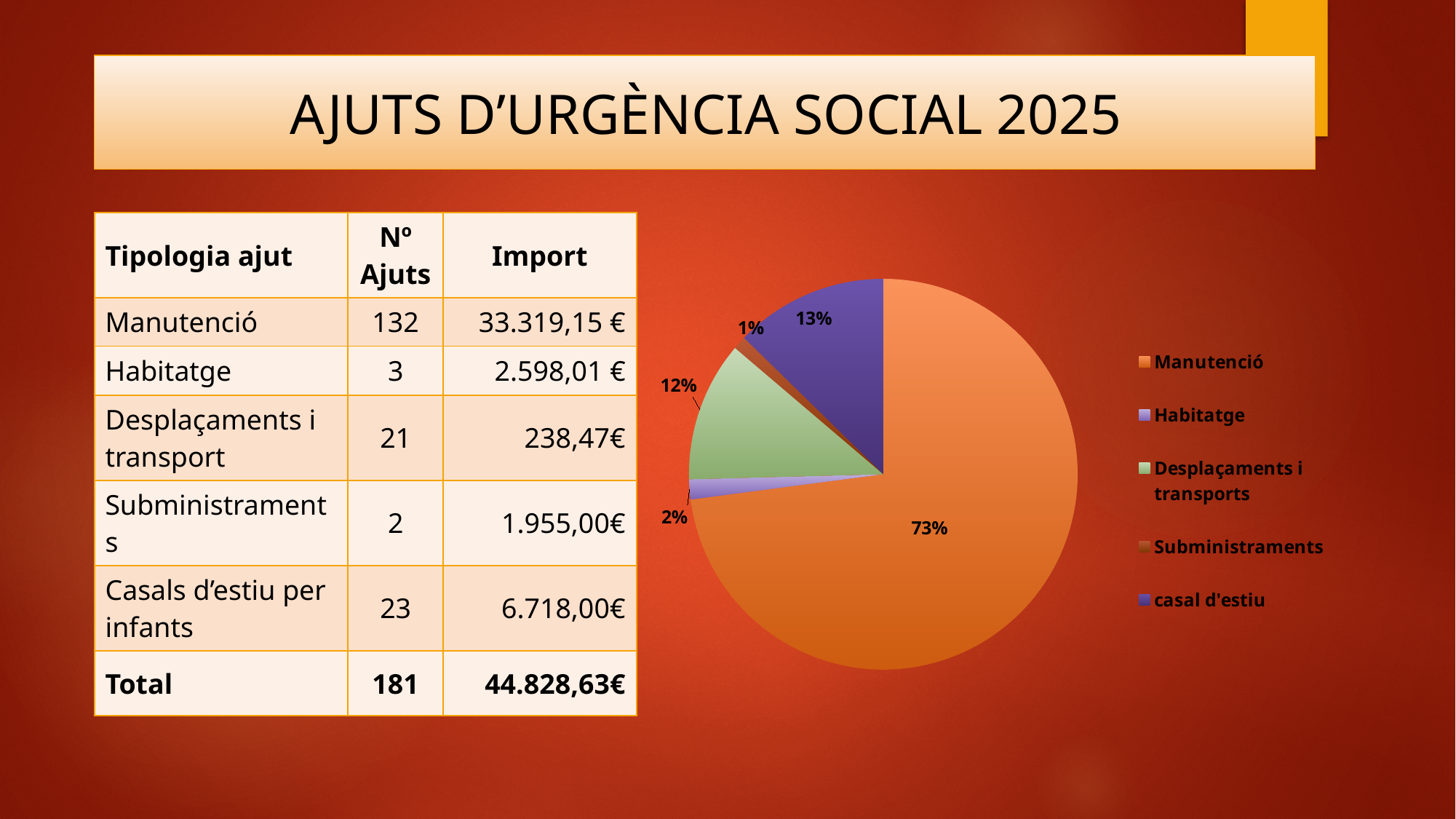
Which category has the largest slice in the pie chart? Manutenció What colour is the Manutenció slice in the pie chart? orange How many categories does the pie chart legend list? 5 What percentage of the pie chart does Manutenció represent? 73% What is the difference in percentage points between the Manutenció slice and the casal d'estiu slice? 60 What percentage of the pie chart does Habitatge represent? 2% What percentage of the pie chart does Desplaçaments i transports represent? 12% In the pie chart, which slice is larger: casal d'estiu or Desplaçaments i transports? casal d'estiu Which category has the smallest slice in the pie chart? Subministraments What kind of chart is shown on the slide? pie chart